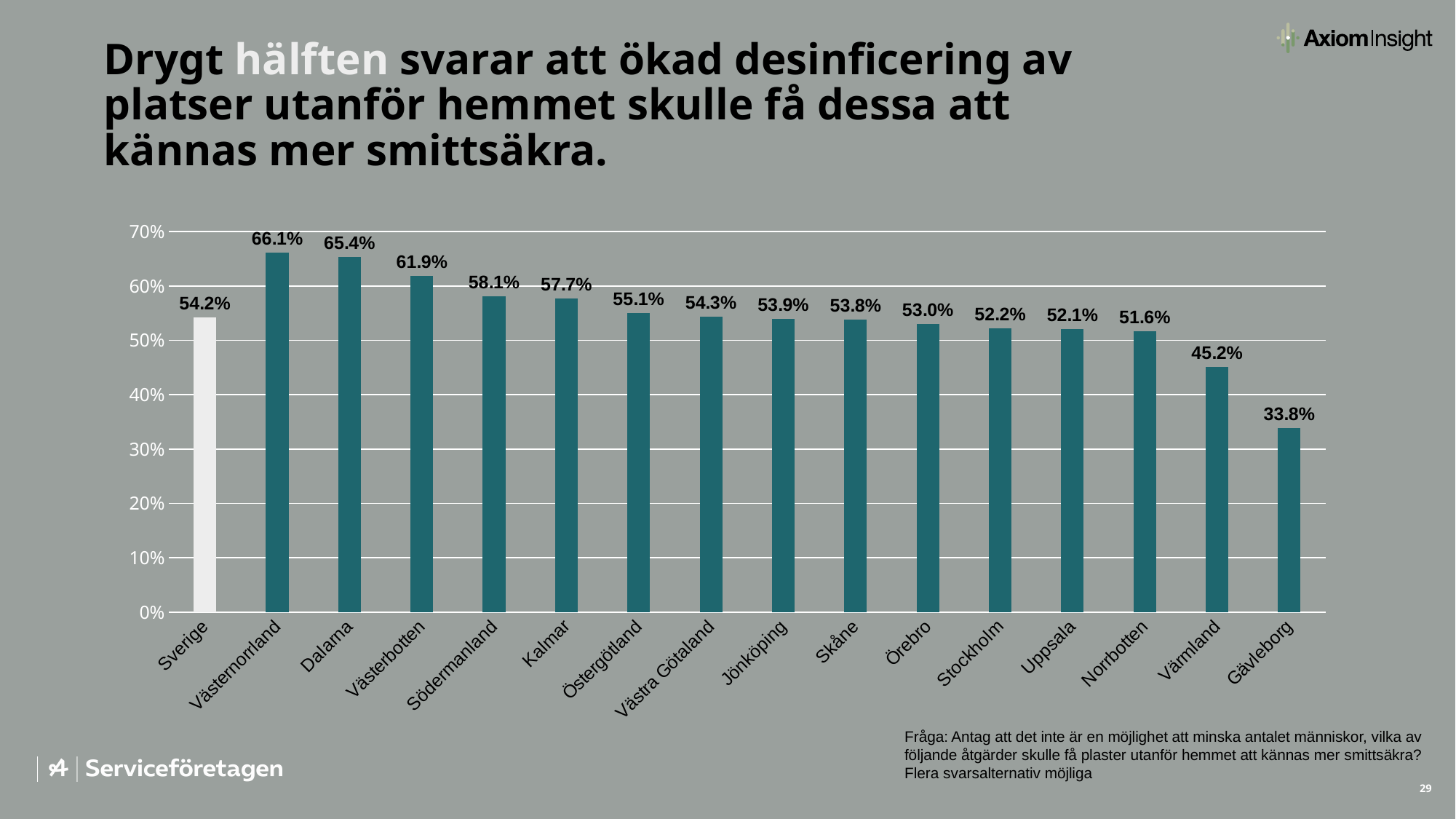
Which has a larger value, Kalmar or Örebro? Kalmar Which bar is shown in a different colour from the others? Sverige Is the value for Gävleborg greater or less than 40%? less How many categories are shown on the x axis? 16 What is the difference between the values for Västernorrland and Gävleborg? 32.3% Which category has the lowest value? Gävleborg What is the value for Värmland? 45.2% What is the value for Sverige? 54.2% What is the difference between the values for Dalarna and Sverige? 11.2% What is the value for Stockholm? 52.2% Which category has the highest value? Västernorrland What kind of chart is shown on the slide? bar chart